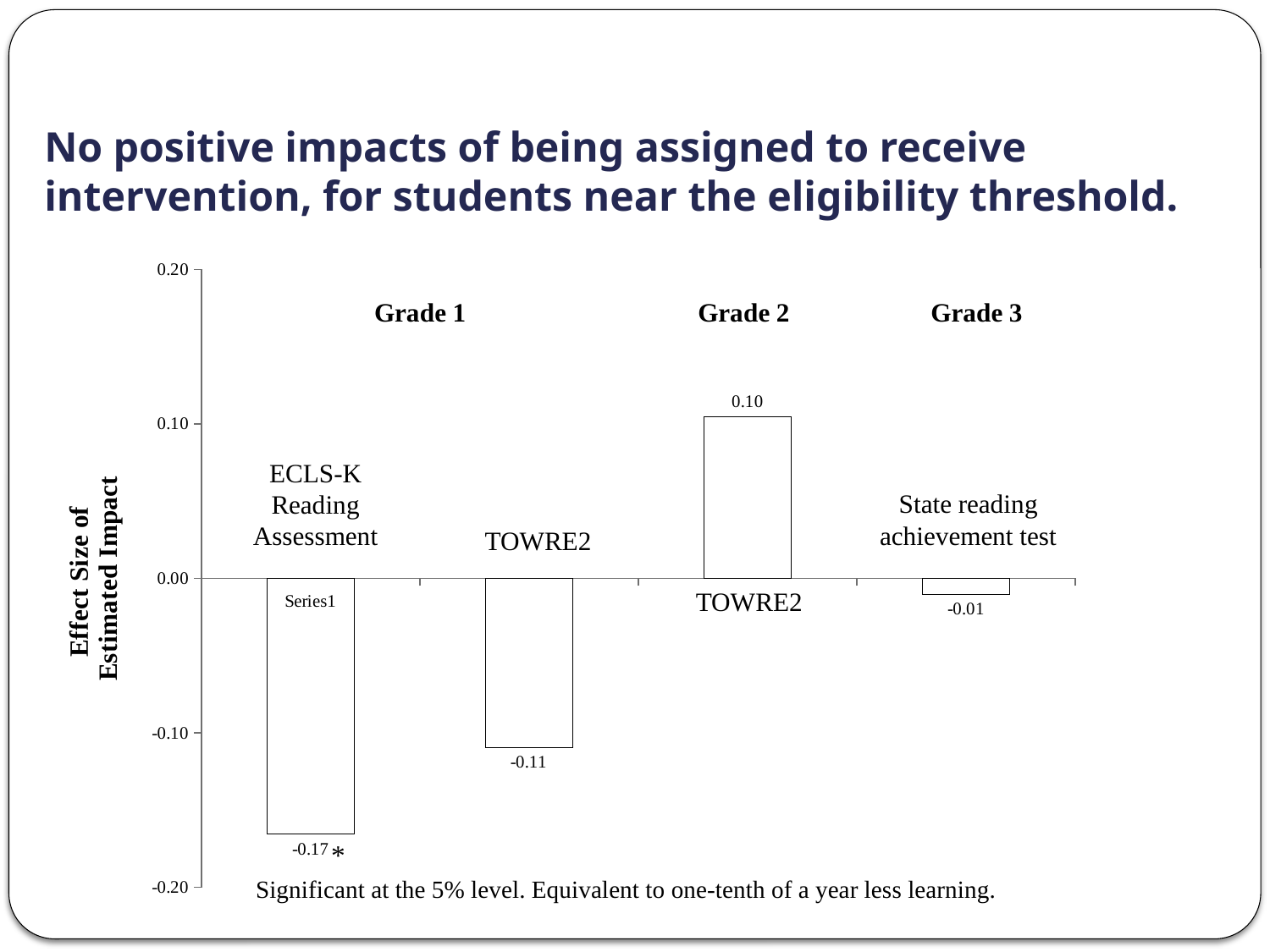
What kind of chart is shown on the slide? Bar chart Which is larger, the effect size for Grade 1 TOWRE2 or for Grade 3 State reading achievement test? Grade 3 State reading achievement test Which measure has the highest effect size? Grade 2 TOWRE2 Which measure has the lowest effect size? Grade 1 ECLS-K Reading Assessment How many bars are plotted in the chart? 4 What is the effect size for the Grade 2 TOWRE2 measure? 0.10 What is the label of the vertical axis? Effect Size of Estimated Impact What is the effect size for the Grade 3 State reading achievement test? -0.01 Is the effect size for the Grade 1 ECLS-K Reading Assessment greater or less than -0.10? less What is the difference between the Grade 2 TOWRE2 effect size and the Grade 1 TOWRE2 effect size? 0.21 What is the effect size for the Grade 1 ECLS-K Reading Assessment? -0.17 What is the effect size for the Grade 1 TOWRE2 measure? -0.11